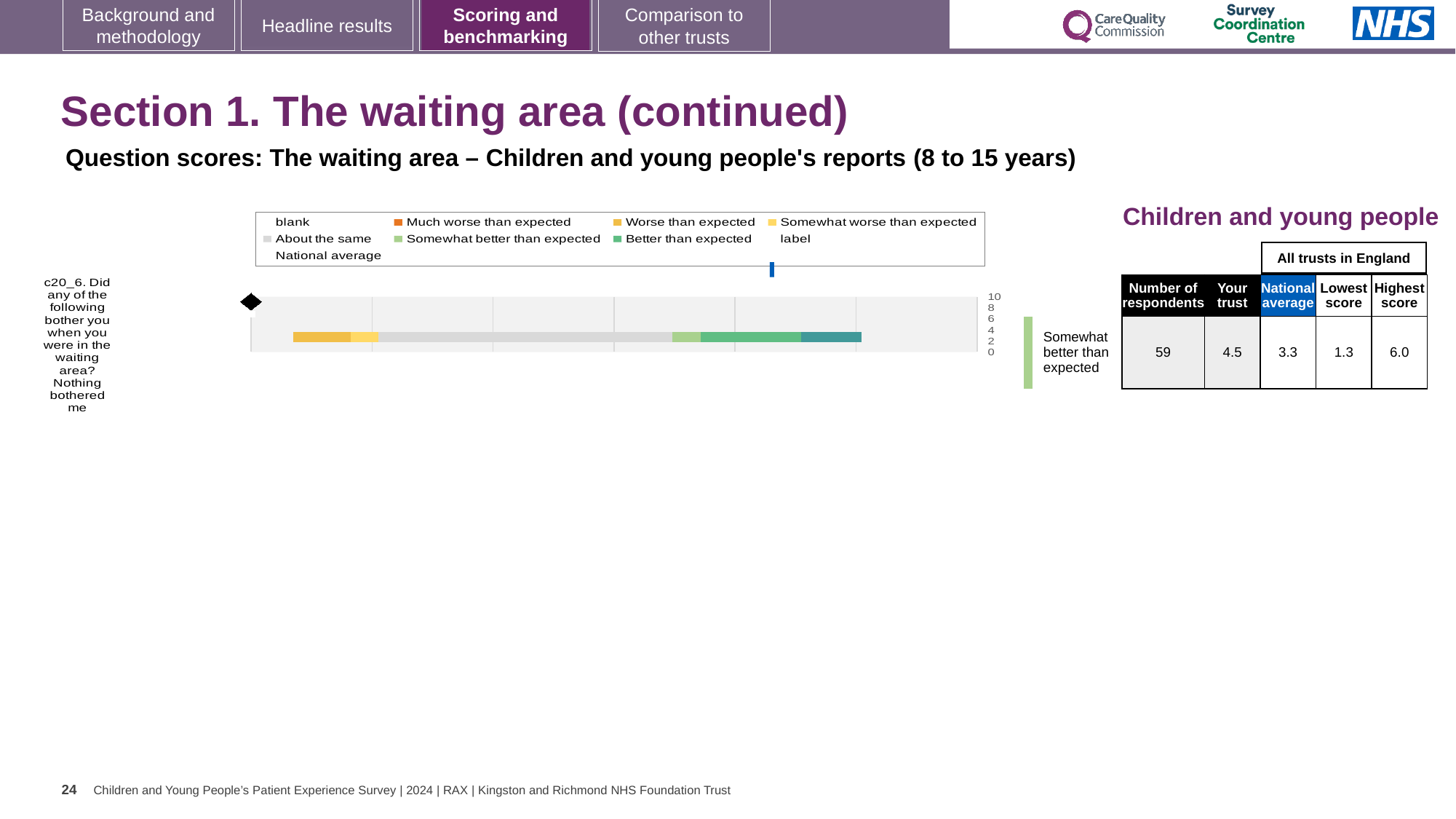
What is the 'Your trust' score for question c20_6 in the table? 4.5 What is the lowest score among all trusts in England for question c20_6? 1.3 What type of chart is used to show the question score for c20_6? bar chart Which is larger for question c20_6, the 'Your trust' score or the national average? Your trust Which survey question is plotted in the chart? c20_6. Did any of the following bother you when you were in the waiting area? Nothing bothered me What is the difference between the highest score and the lowest score for question c20_6? 4.7 What benchmark rating is shown next to the bar for question c20_6? Somewhat better than expected What is the highest score among all trusts in England for question c20_6? 6.0 How many survey questions are plotted in the chart? 1 How many respondents answered question c20_6? 59 What is the national average score for question c20_6 in the table? 3.3 In the chart legend, what colour represents 'About the same'? grey